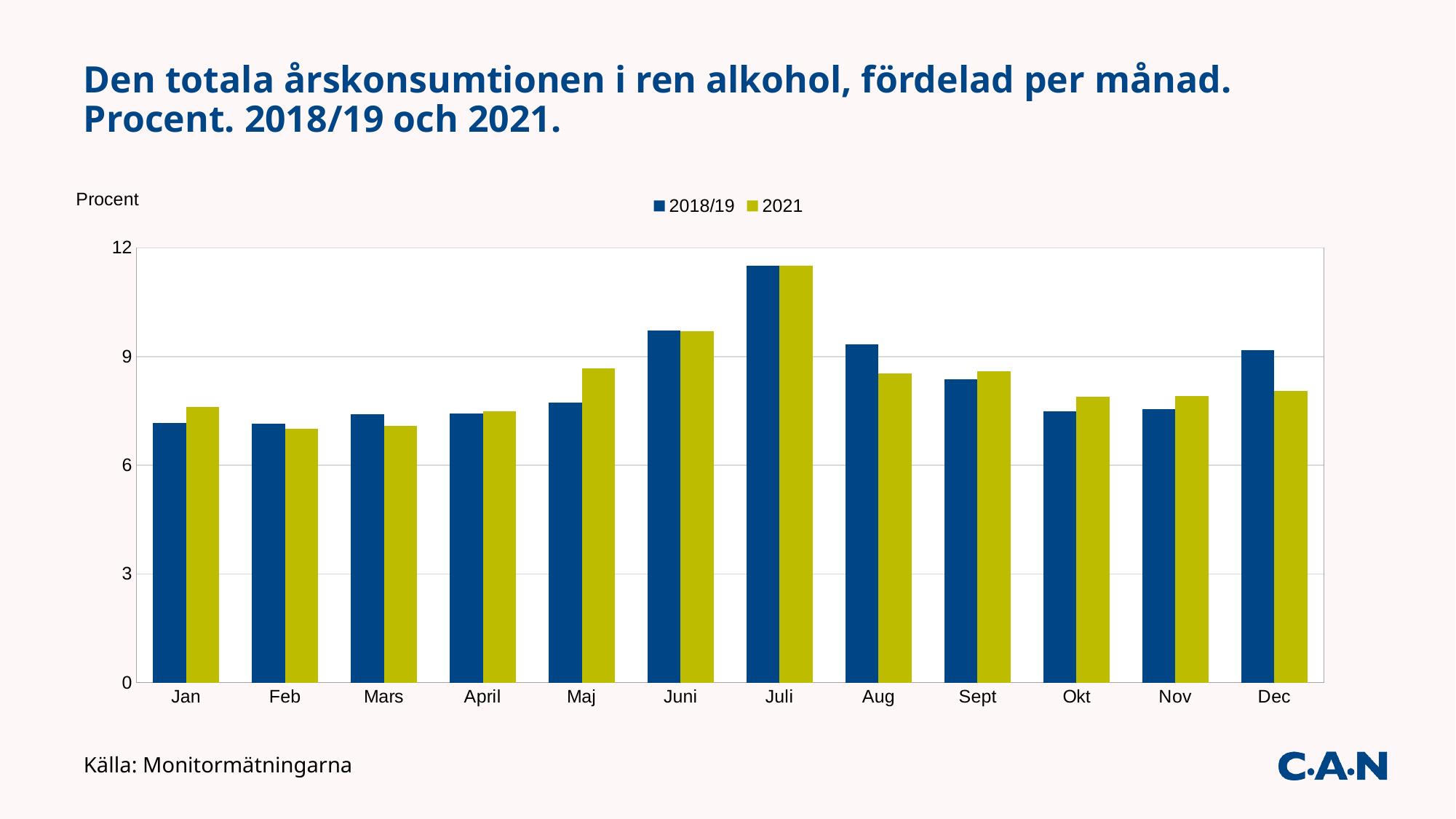
Which month has the highest value for the 2021 series? Juli Do the values for the 2018/19 series rise or fall from Juli to Okt? fall What source is cited below the chart? Monitormätningarna How many months are shown on the x axis? 12 What kind of chart is shown on the slide? bar chart How many series does the legend list? 2 In Aug, which series has the larger value, 2018/19 or 2021? 2018/19 Is the value for Aug in the 2021 series greater or less than 9? less Which month has the highest value for the 2018/19 series? Juli Is the value for Juli in the 2018/19 series greater or less than 9? greater In Dec, which series has the larger value, 2018/19 or 2021? 2018/19 In Maj, which series has the larger value, 2018/19 or 2021? 2021